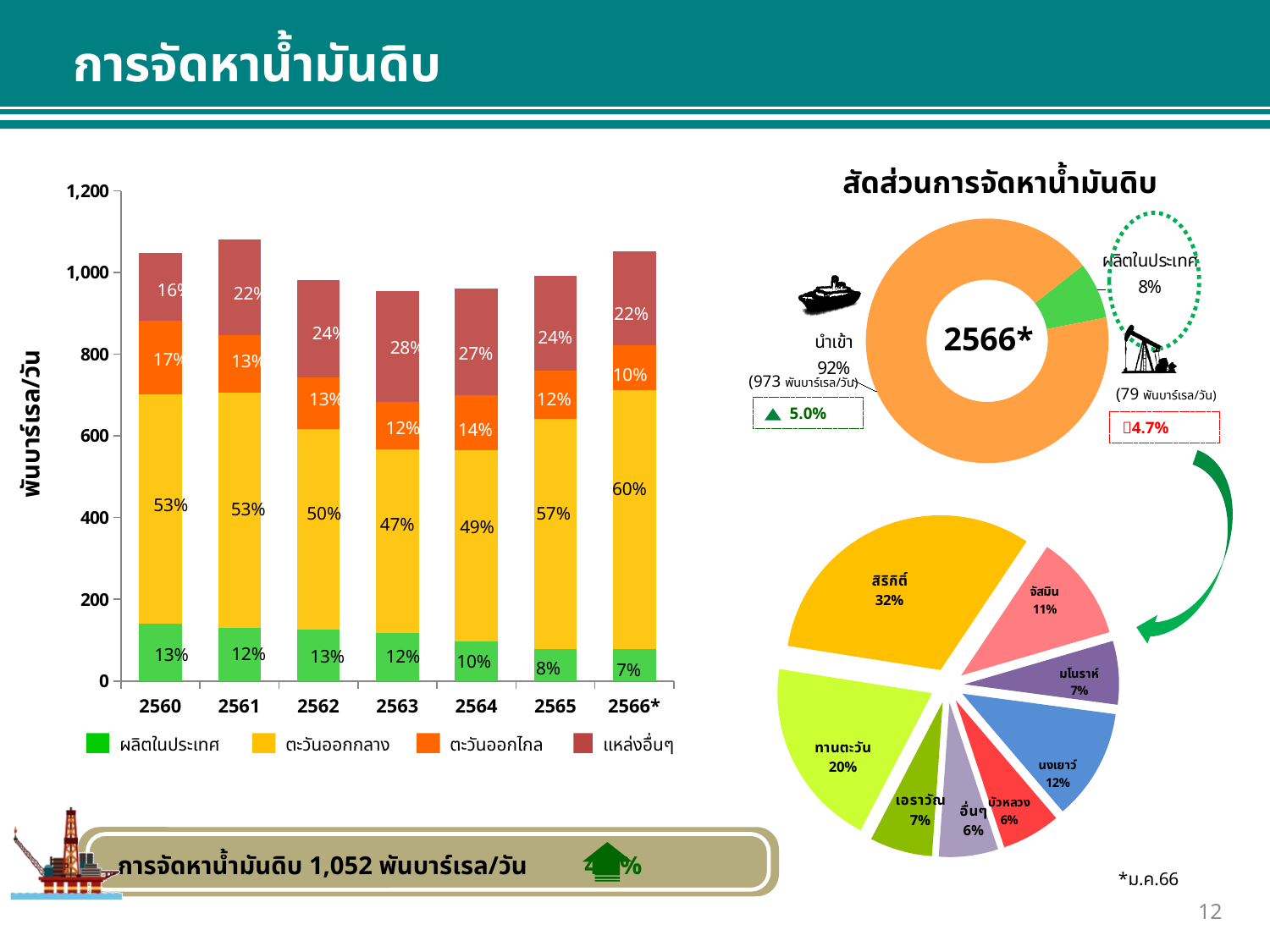
In the pie chart at the bottom right, which is larger, ทานตะวัน or จัสมิน? ทานตะวัน In the stacked bar chart on the left, is the total height of the 2563 bar greater or less than 1,000? less In the stacked bar chart on the left, does the share for ผลิตในประเทศ generally rise or fall from 2560 to 2566*? fall In the stacked bar chart on the left, what is the share for ตะวันออกกลาง in 2566*? 60% In the stacked bar chart on the left, how many series does the legend list? 4 In the donut chart titled สัดส่วนการจัดหาน้ำมันดิบ, what share is นำเข้า? 92% In the pie chart at the bottom right, which field has the largest slice? สิริกิติ์ In the stacked bar chart on the left, which year has the lowest share for ผลิตในประเทศ? 2566* In the stacked bar chart on the left, what is the share for แหล่งอื่นๆ in 2563? 28% In the stacked bar chart on the left, how many years are shown on the x axis? 7 In the pie chart at the bottom right, what is the share for นงเยาว์? 12% In the stacked bar chart on the left, which year has the highest share for ตะวันออกกลาง? 2566*